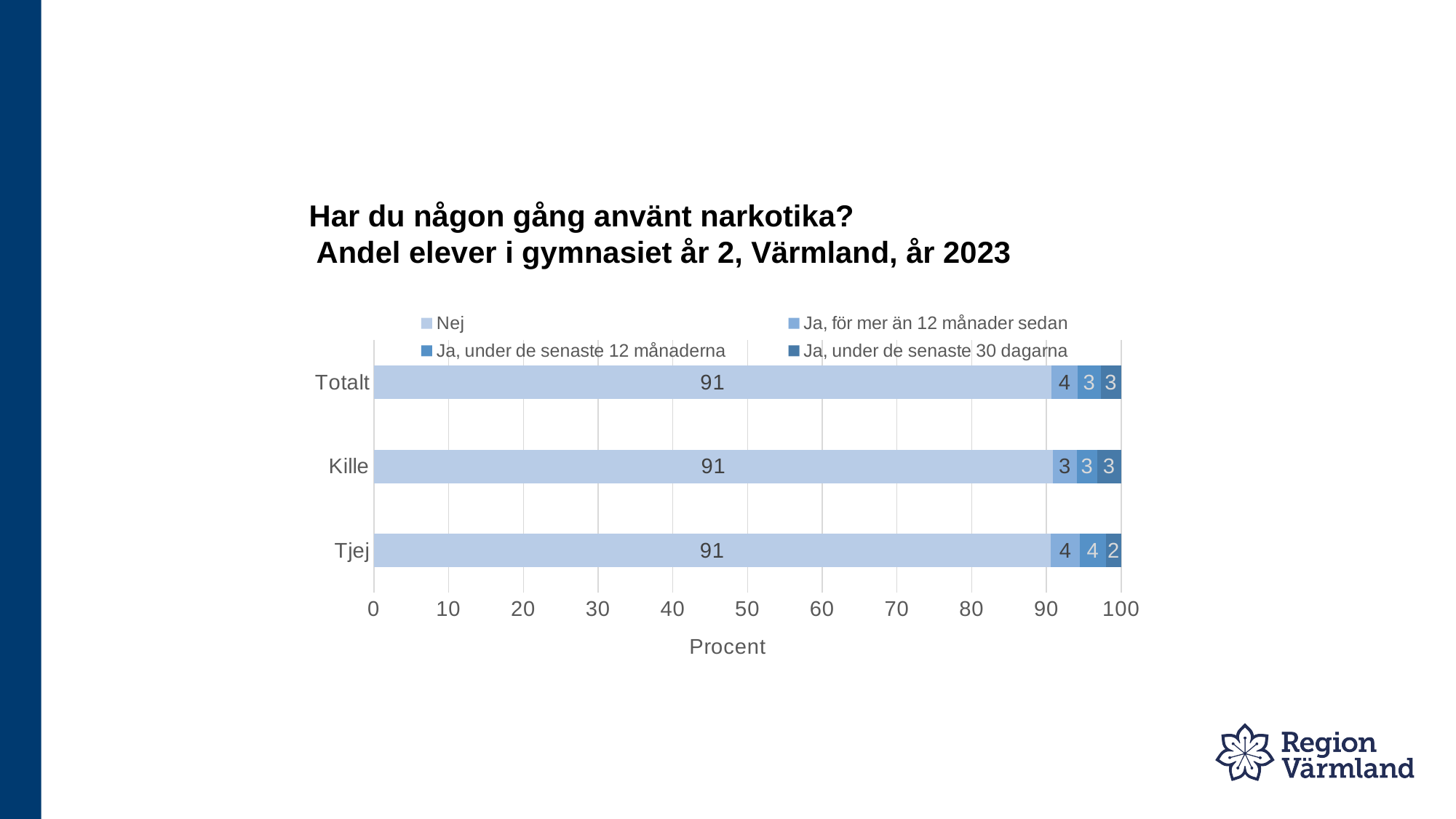
What is the value of 'Nej' for Kille? 91 What is the label of the horizontal axis? Procent Which is larger: 'Ja, för mer än 12 månader sedan' for Tjej or for Kille? Tjej How many series does the legend list? 4 Which category has the lowest value for 'Ja, under de senaste 30 dagarna'? Tjej What is the difference between 'Ja, under de senaste 30 dagarna' for Kille and for Tjej? 1 What is the value of 'Ja, under de senaste 12 månaderna' for Tjej? 4 How many categories are shown on the vertical axis? 3 What type of chart is shown on the slide? Stacked bar chart What is the value of 'Ja, för mer än 12 månader sedan' for Totalt? 4 What is the total of the stacked bar for Kille? 100 What is the value of 'Ja, under de senaste 30 dagarna' for Tjej? 2